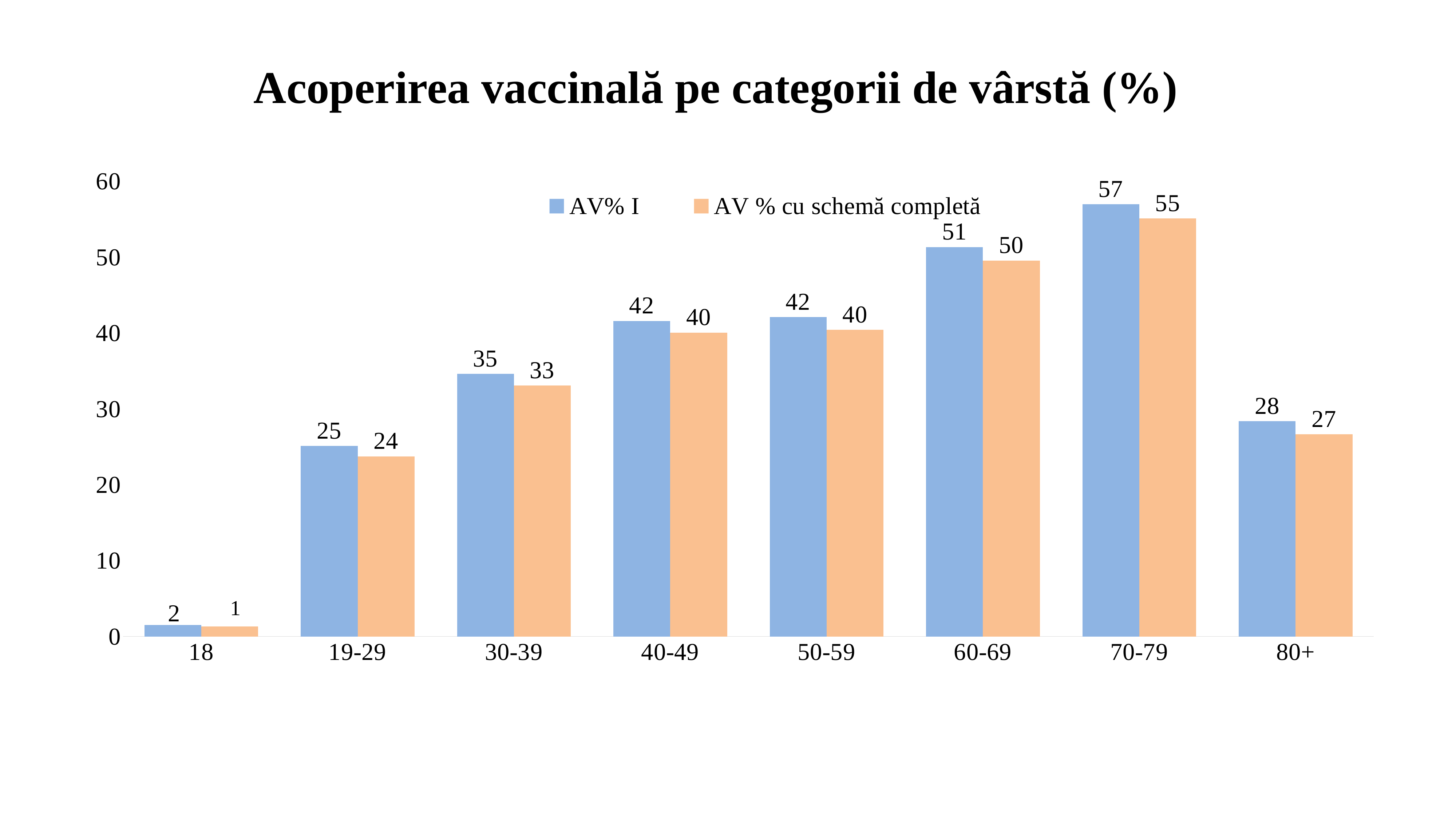
What is the AV % cu schemă completă value for the 30-39 age group? 33 How many series does the legend list? 2 What is the AV% I value for the 80+ age group? 28 Which is larger: the AV% I value for 19-29 or the AV% I value for 30-39? 30-39 Which age group has the lowest AV% I value? 18 What is the AV% I value for the 70-79 age group? 57 Which age group has the highest AV % cu schemă completă value? 70-79 What is the title of the chart? Acoperirea vaccinală pe categorii de vârstă (%) What is the difference between the AV% I and AV % cu schemă completă values for the 60-69 age group? 1 What kind of chart is shown on the slide? Bar chart What is the difference between the AV% I values for the 70-79 and 80+ age groups? 29 How many age groups are shown on the x axis? 8